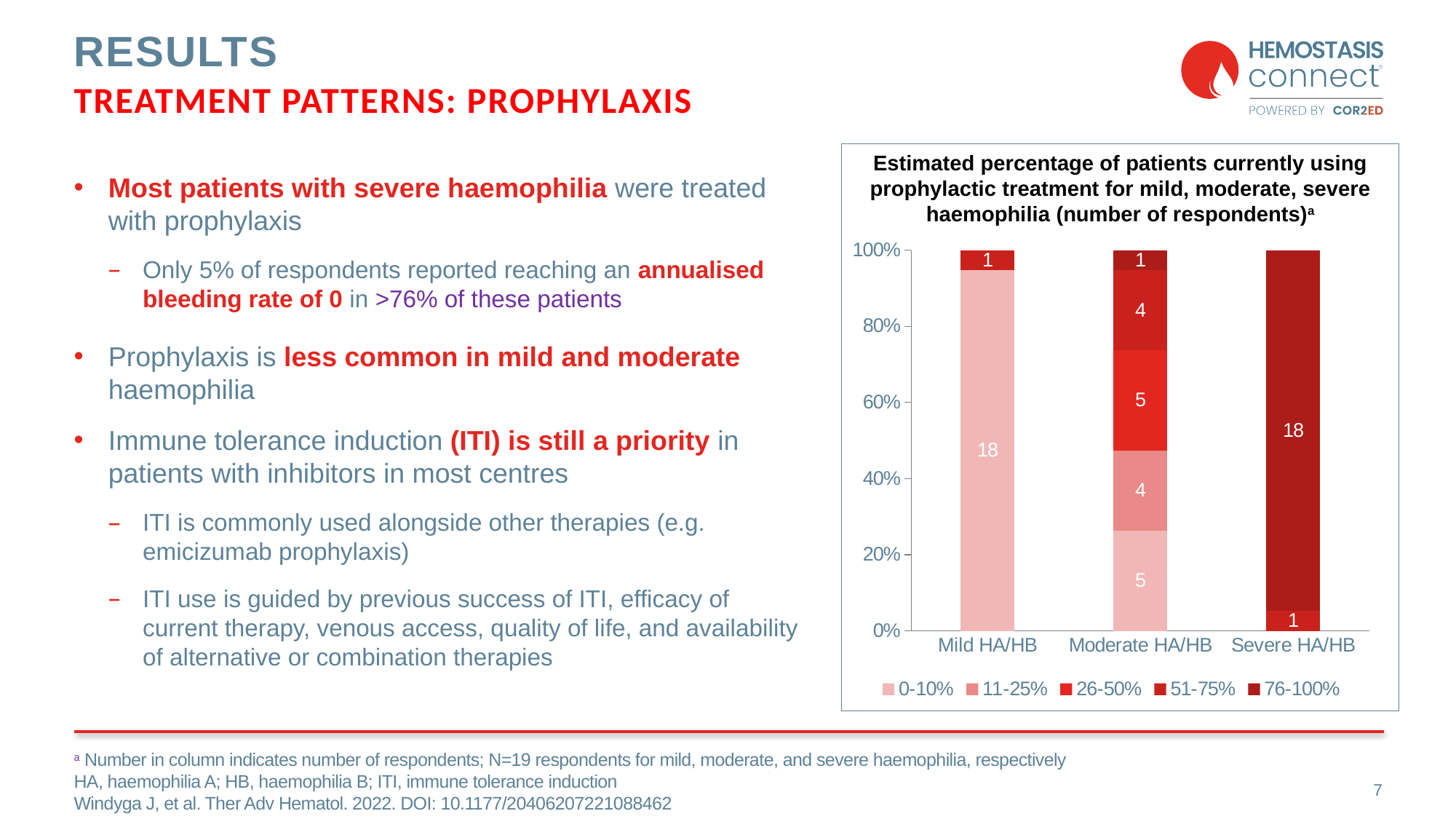
How many categories are shown on the x axis of the chart? 3 Which has more respondents: the 0-10% segment for Mild HA/HB or the 0-10% segment for Severe HA/HB? Mild HA/HB What is the difference between the number of respondents in the 0-10% segment for Mild HA/HB and the 0-10% segment for Moderate HA/HB? 13 How many respondents are in the 0-10% segment for Mild HA/HB? 18 Which legend entry is listed first in the chart legend? 0-10% How many respondents are in the 0-10% segment for Severe HA/HB? 0 How many respondents are in the 76-100% segment for Severe HA/HB? 18 What kind of chart is shown on the slide? Stacked bar chart How many respondents are in the 11-25% segment for Moderate HA/HB? 4 What is the total number of respondents across all segments of the Moderate HA/HB bar? 19 How many respondents are in the 26-50% segment for Moderate HA/HB? 5 How many series does the chart legend list? 5